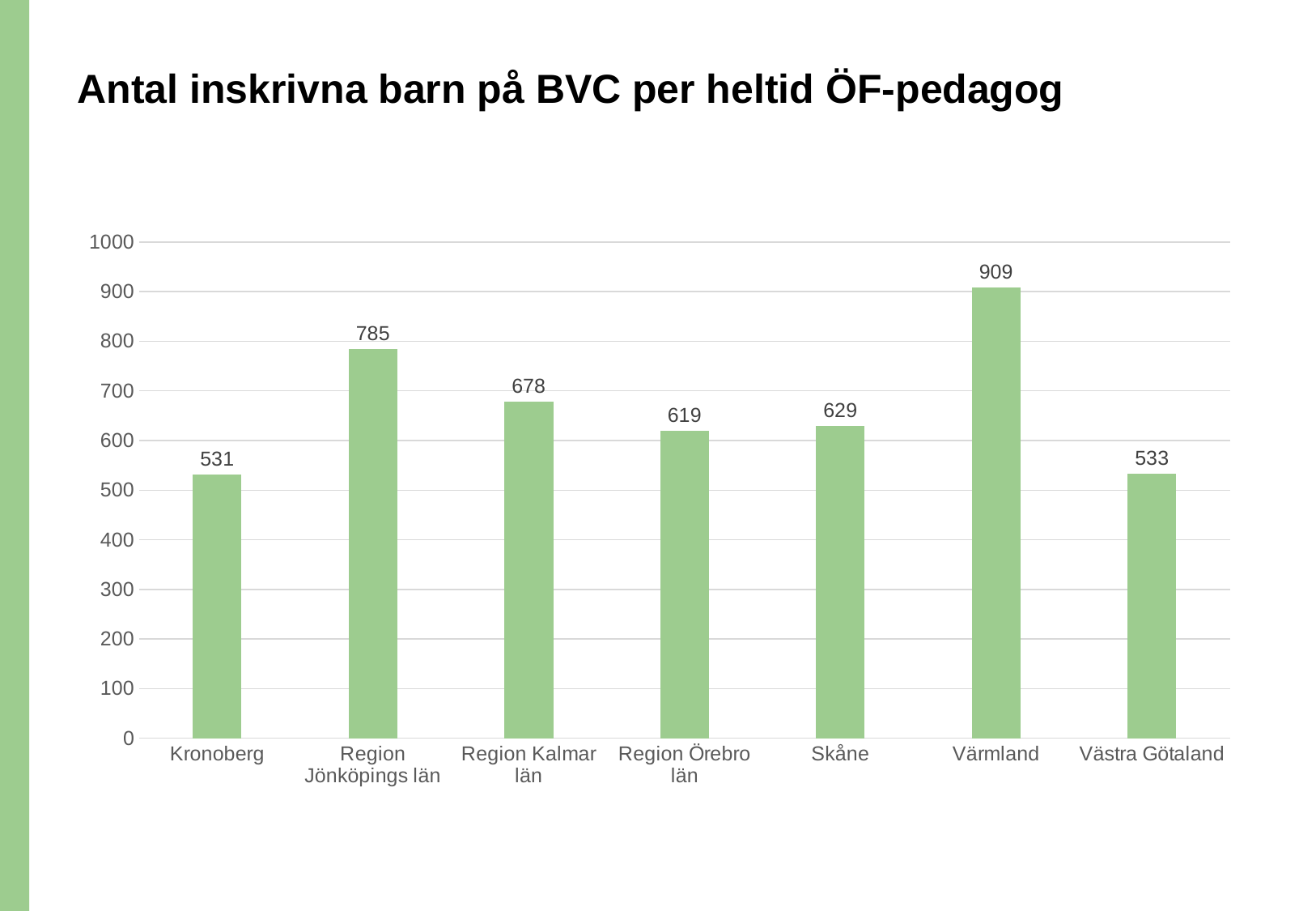
Is the value for Västra Götaland greater or less than 600? less What is the difference between the values for Värmland and Kronoberg? 378 How many regions are shown on the x axis? 7 What is the value for Skåne? 629 What kind of chart is shown on the slide? bar chart Which is larger, the value for Region Kalmar län or the value for Region Örebro län? Region Kalmar län What is the value for Värmland? 909 Which region has the lowest value? Kronoberg Which region has the highest value? Värmland What is the difference between the values for Region Jönköpings län and Region Kalmar län? 107 What is the title of the chart? Antal inskrivna barn på BVC per heltid ÖF-pedagog What is the value for Region Jönköpings län? 785